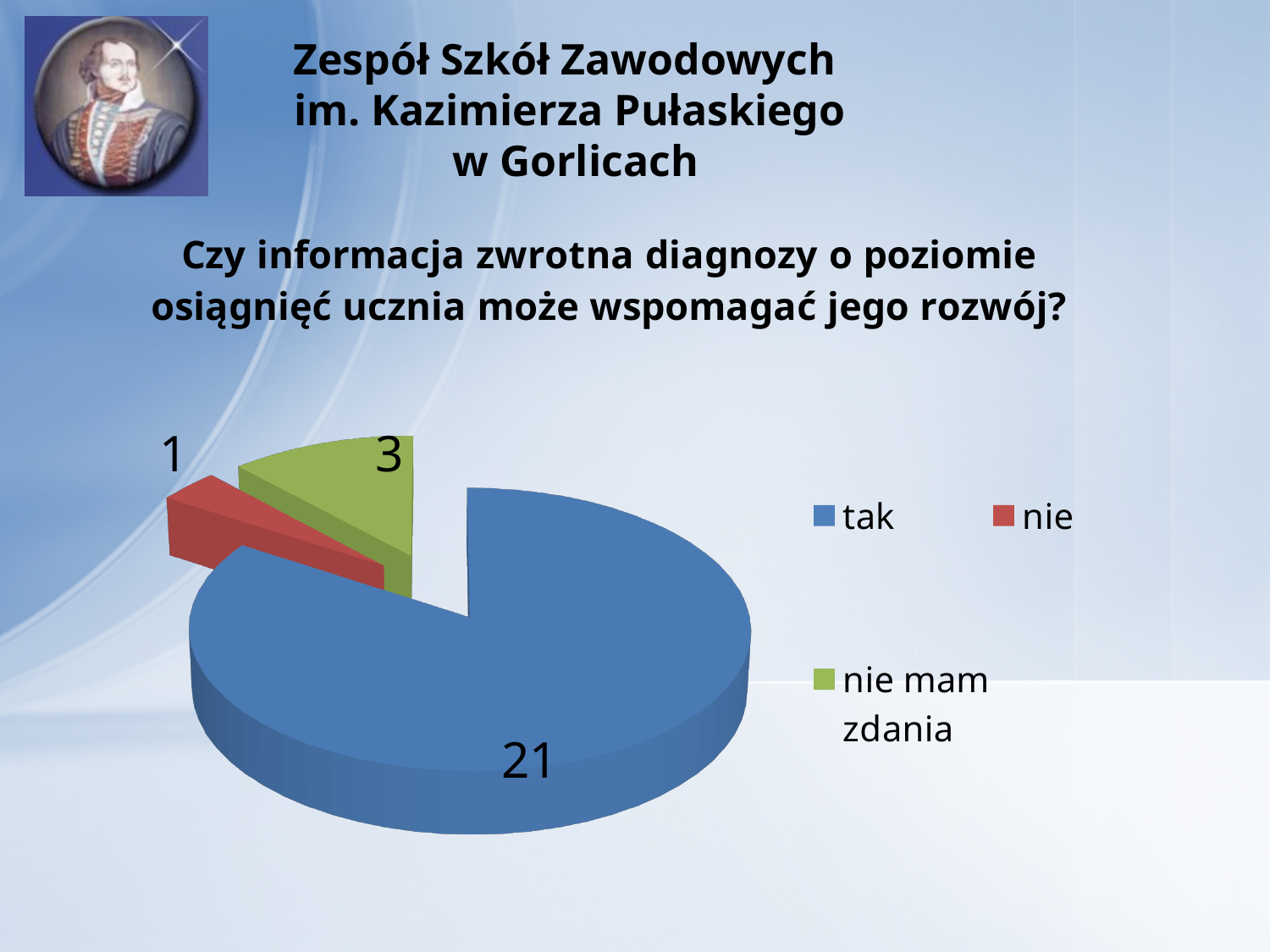
Which has more responses, "nie" or "nie mam zdania"? nie mam zdania How many categories does the pie chart have? 3 Which answer category has the smallest slice of the pie? nie What is the difference between the number of "tak" responses and the number of "nie mam zdania" responses? 18 How many entries does the legend list? 3 How many responses are shown for "nie"? 1 How many responses are shown for "nie mam zdania"? 3 What kind of chart is shown on the slide? pie chart Which answer category has the largest slice of the pie? tak What share of all responses does the "tak" slice represent? 84% What is the total number of responses across all slices of the pie? 25 How many responses are shown for "tak"? 21